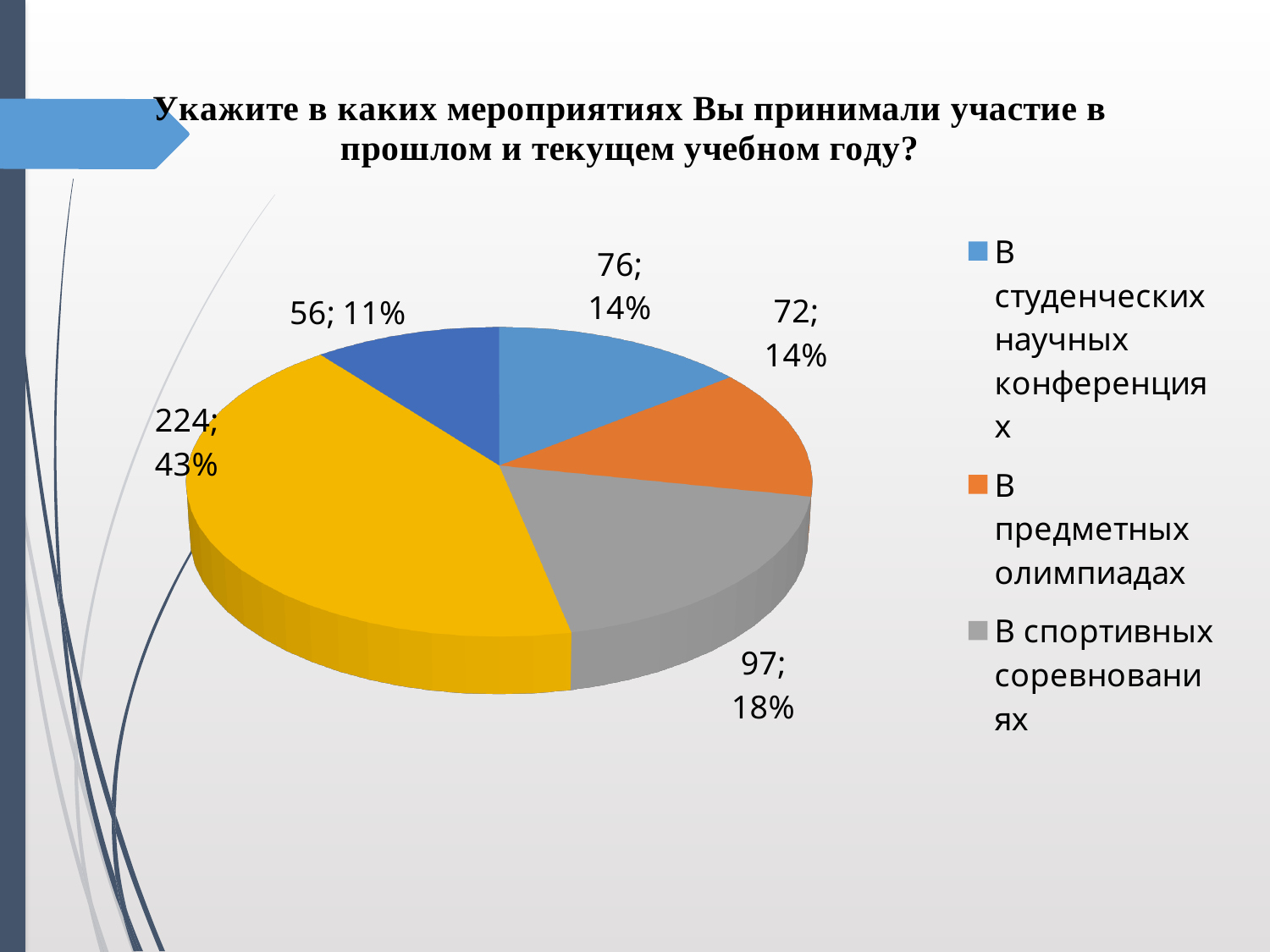
What is the number of respondents shown for "В спортивных соревнованиях"? 97 What is the difference between the values for "В спортивных соревнованиях" and "В студенческих научных конференциях"? 21 How many slices does the pie chart have? 5 What value is printed on the largest slice of the pie chart? 224 Which has a larger value: "В спортивных соревнованиях" or "В предметных олимпиадах"? В спортивных соревнованиях What is the number of respondents shown for "В студенческих научных конференциях"? 76 What percentage share does "В предметных олимпиадах" have in the pie chart? 14% What value is printed on the smallest slice of the pie chart? 56 What percentage share does "В спортивных соревнованиях" have in the pie chart? 18% What colour is the slice for "В предметных олимпиадах"? orange What is the title of the chart on the slide? Укажите в каких мероприятиях Вы принимали участие в прошлом и текущем учебном году? What kind of chart is shown on the slide? pie chart